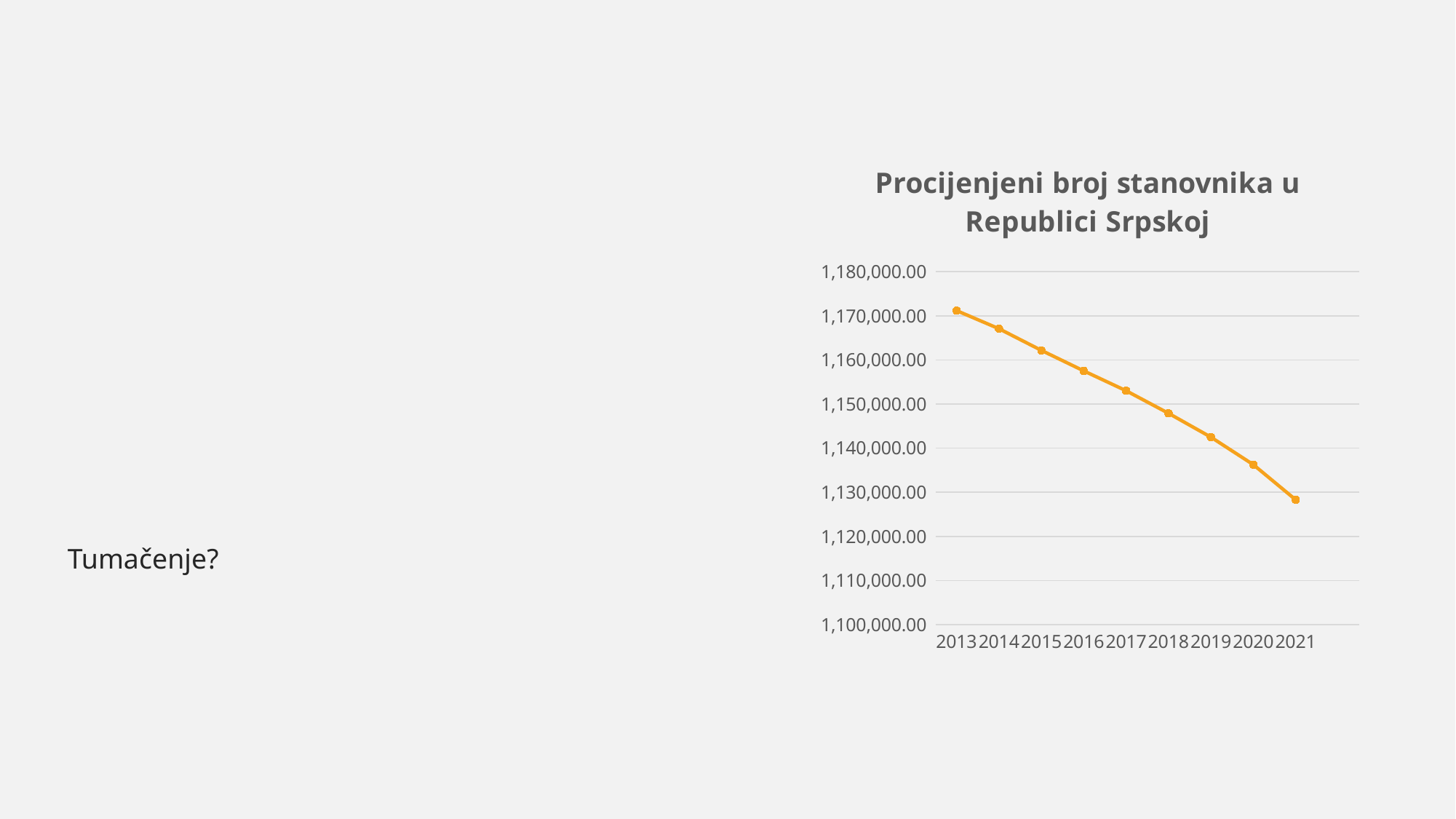
Is the value for 2015 greater or less than 1,160,000.00? greater How many years are plotted on the x axis of the chart? 9 Is the value for 2021 greater or less than 1,130,000.00? less Do the values rise or fall from 2013 to 2021? fall What is the title of the chart? Procijenjeni broj stanovnika u Republici Srpskoj What colour is the line in the chart? orange Which year has the highest estimated population? 2013 Is the value for 2014 greater or less than 1,170,000.00? less What kind of chart is shown on the slide? line chart Which year has the lowest estimated population? 2021 Which year has the larger value, 2016 or 2020? 2016